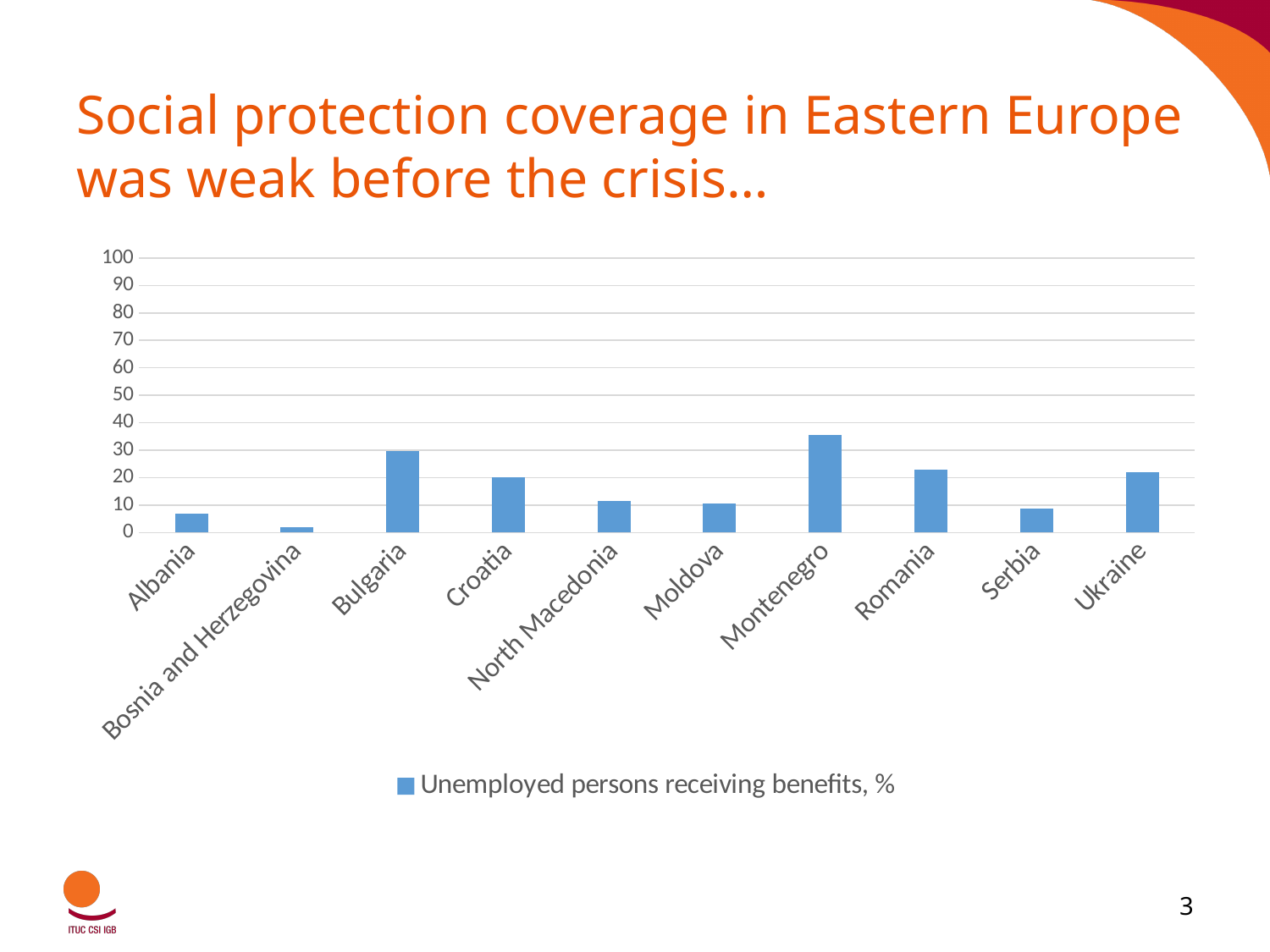
What series name is shown in the chart legend? Unemployed persons receiving benefits, % Is the value for Montenegro greater or less than 30? greater Is the value for Croatia greater or less than 30? less How many series does the chart legend list? 1 How many countries are shown on the x axis of the chart? 10 What kind of chart is shown on the slide? bar chart Which country has the lowest share of unemployed persons receiving benefits? Bosnia and Herzegovina Which has a higher value, Bulgaria or Croatia? Bulgaria Is the value for Bosnia and Herzegovina greater or less than 10? less Which has a higher value, Montenegro or Romania? Montenegro Which country has the highest share of unemployed persons receiving benefits? Montenegro